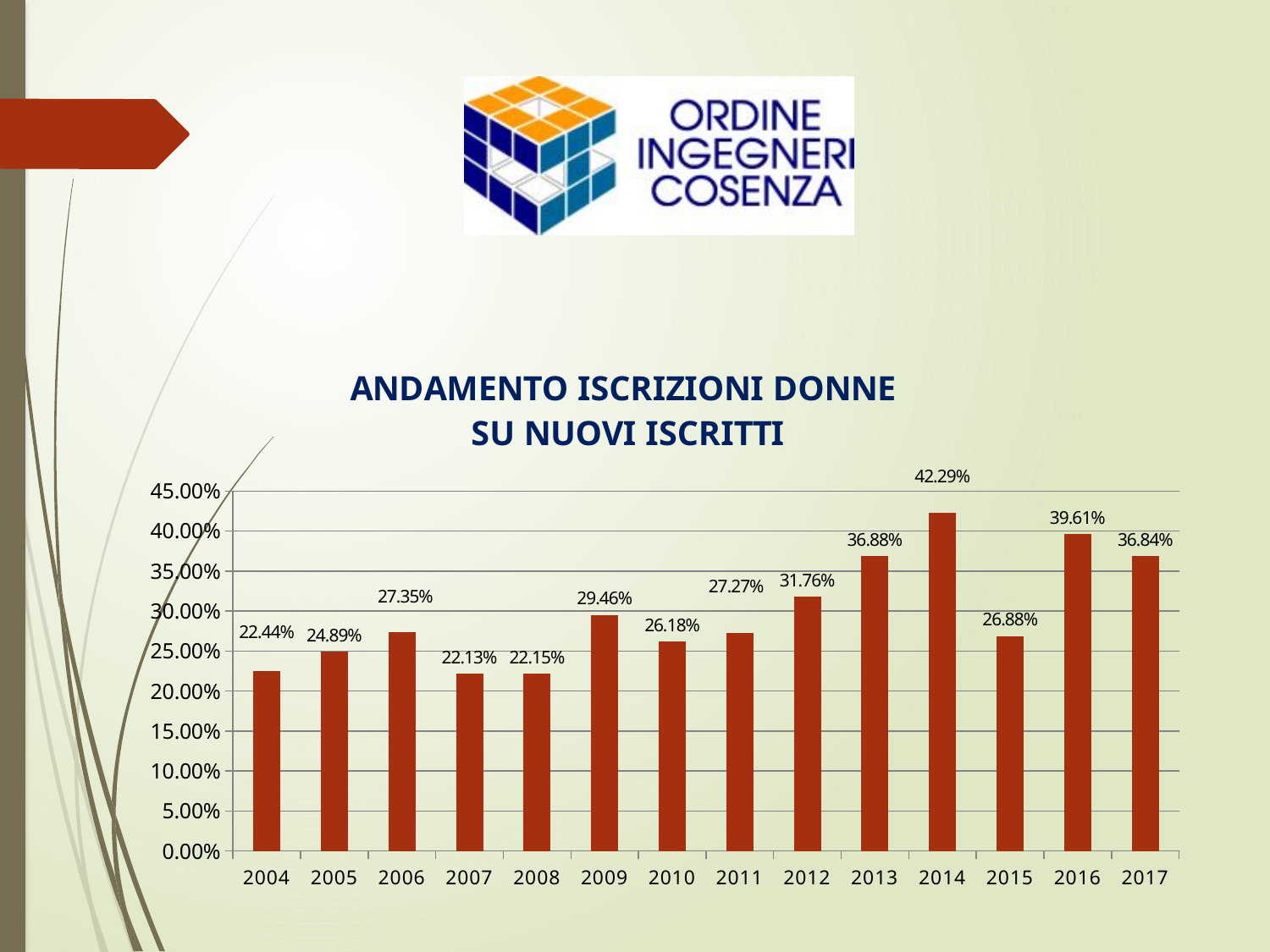
Which is larger, the value for 2012 or the value for 2009? 2012 Which year has the highest value? 2014 What is the value for 2009? 29.46% What type of chart is shown on the slide? Bar chart What is the value for 2014? 42.29% How many years are shown on the x axis? 14 What is the difference between the values for 2016 and 2015? 12.73 percentage points What is the difference between the values for 2014 and 2013? 5.41 percentage points What is the value for 2004? 22.44% Is the value for 2015 greater or less than 30.00%? less What is the title of the chart? ANDAMENTO ISCRIZIONI DONNE SU NUOVI ISCRITTI Do the values rise or fall from 2012 to 2014? rise